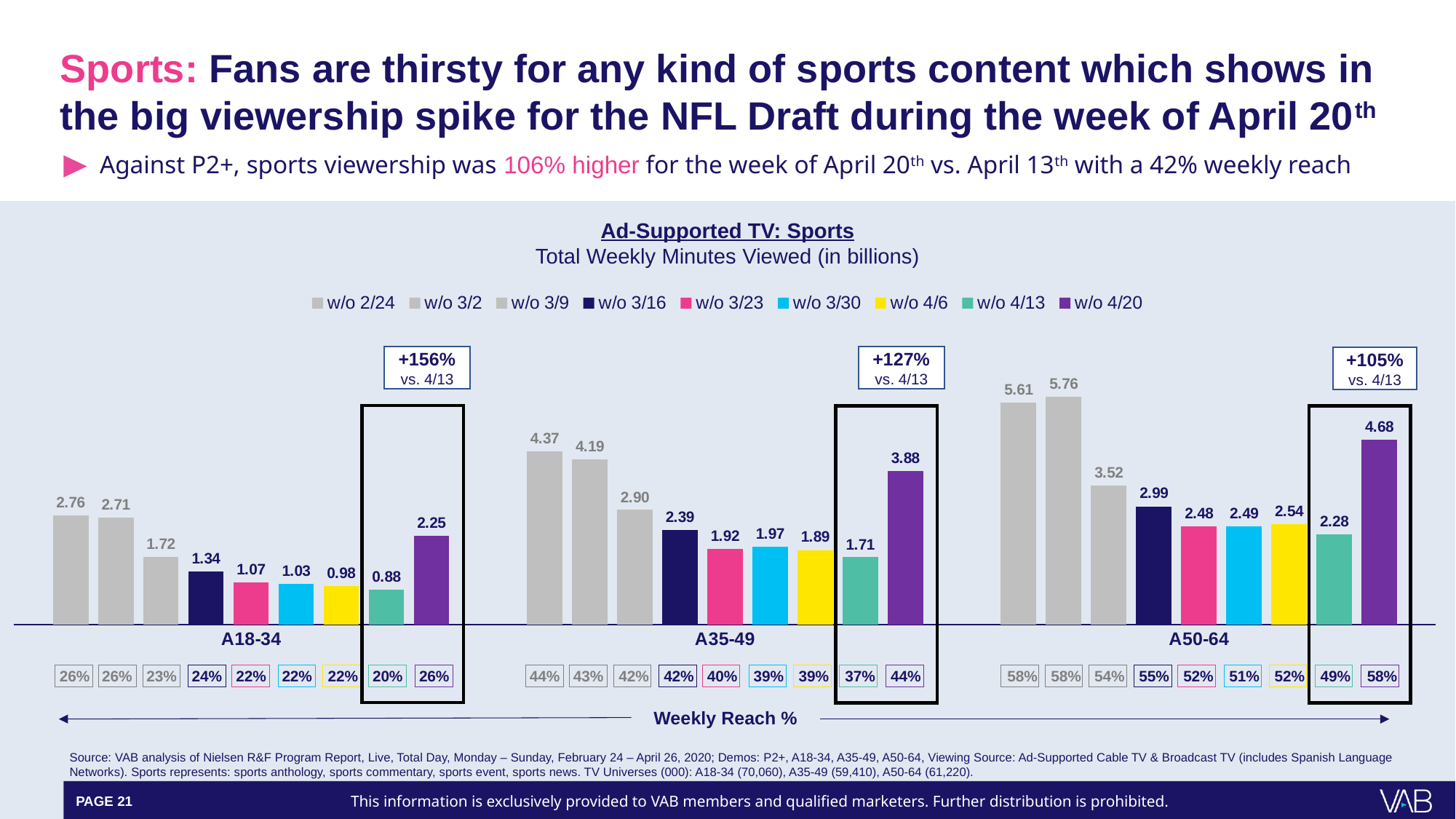
What is the title of the chart? Ad-Supported TV: Sports Which week has the highest value in the A50-64 group? w/o 3/2 What is the difference between the w/o 4/20 and w/o 4/13 values in the A50-64 group? 2.40 How many series does the chart legend list? 9 What is the value for w/o 4/20 in the A18-34 group? 2.25 In the A18-34 group, which is larger: the value for w/o 3/16 or w/o 3/23? w/o 3/16 What kind of chart is shown on the slide? bar chart How many demographic groups are shown along the x axis of the chart? 3 What percentage increase vs. 4/13 is annotated above the A35-49 group? +127% What is the value for w/o 2/24 in the A50-64 group? 5.61 What is the value for w/o 4/13 in the A35-49 group? 1.71 Which week has the lowest value in the A18-34 group? w/o 4/13